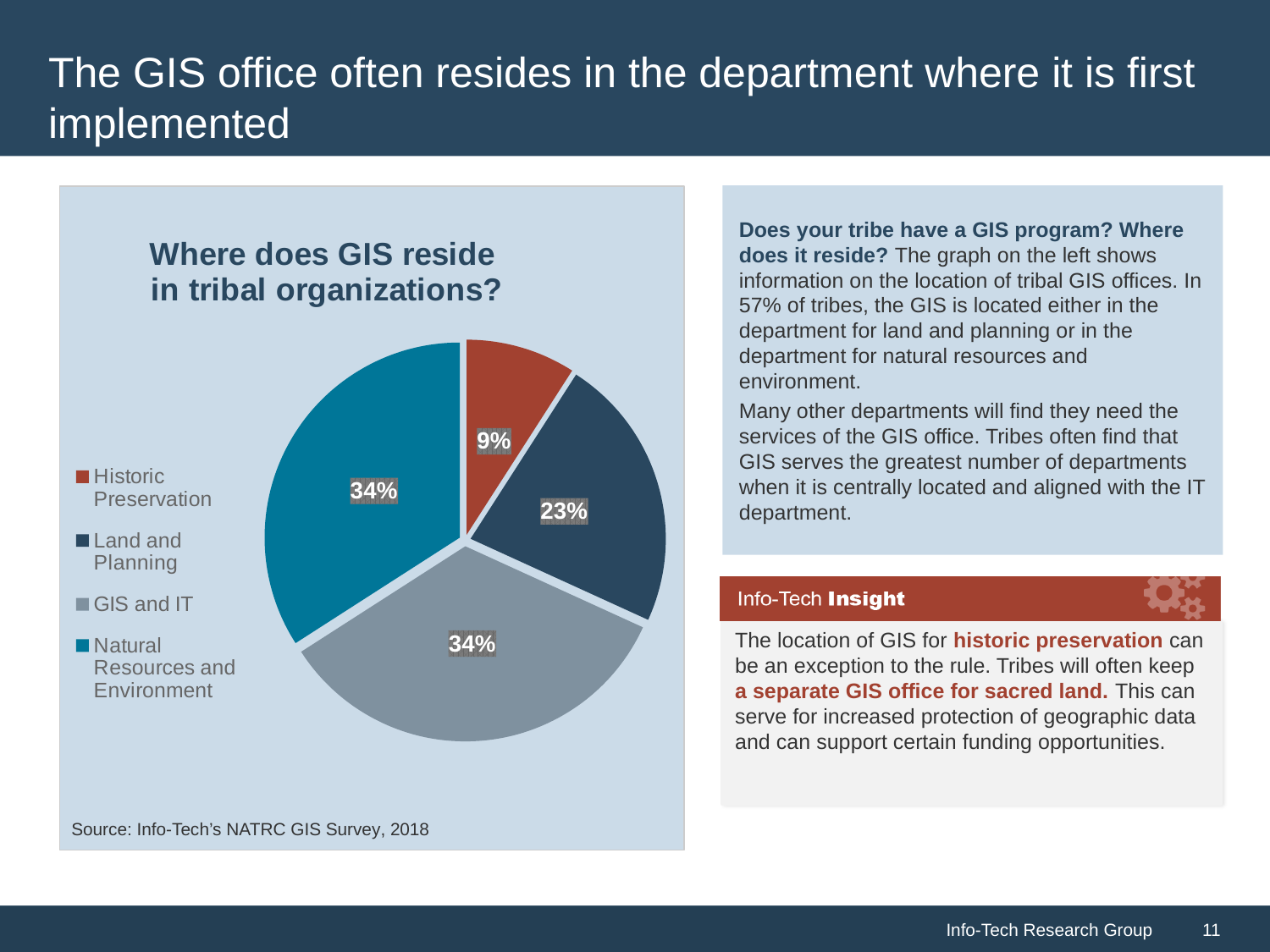
What share of the pie does Land and Planning represent? 23% How many categories does the pie chart show? 4 What is the difference in percentage points between the Land and Planning slice and the Historic Preservation slice? 14 What is the combined share of the GIS and IT slice and the Natural Resources and Environment slice? 68% What share of the pie does GIS and IT represent? 34% What colour is the slice for Natural Resources and Environment? Teal What kind of chart is shown on the slide? Pie chart What share of the pie does Historic Preservation represent? 9% Which category has the smallest slice of the pie? Historic Preservation What share of the pie does Natural Resources and Environment represent? 34% What is the title of the chart? Where does GIS reside in tribal organizations? Which is larger, the slice for Land and Planning or the slice for Historic Preservation? Land and Planning